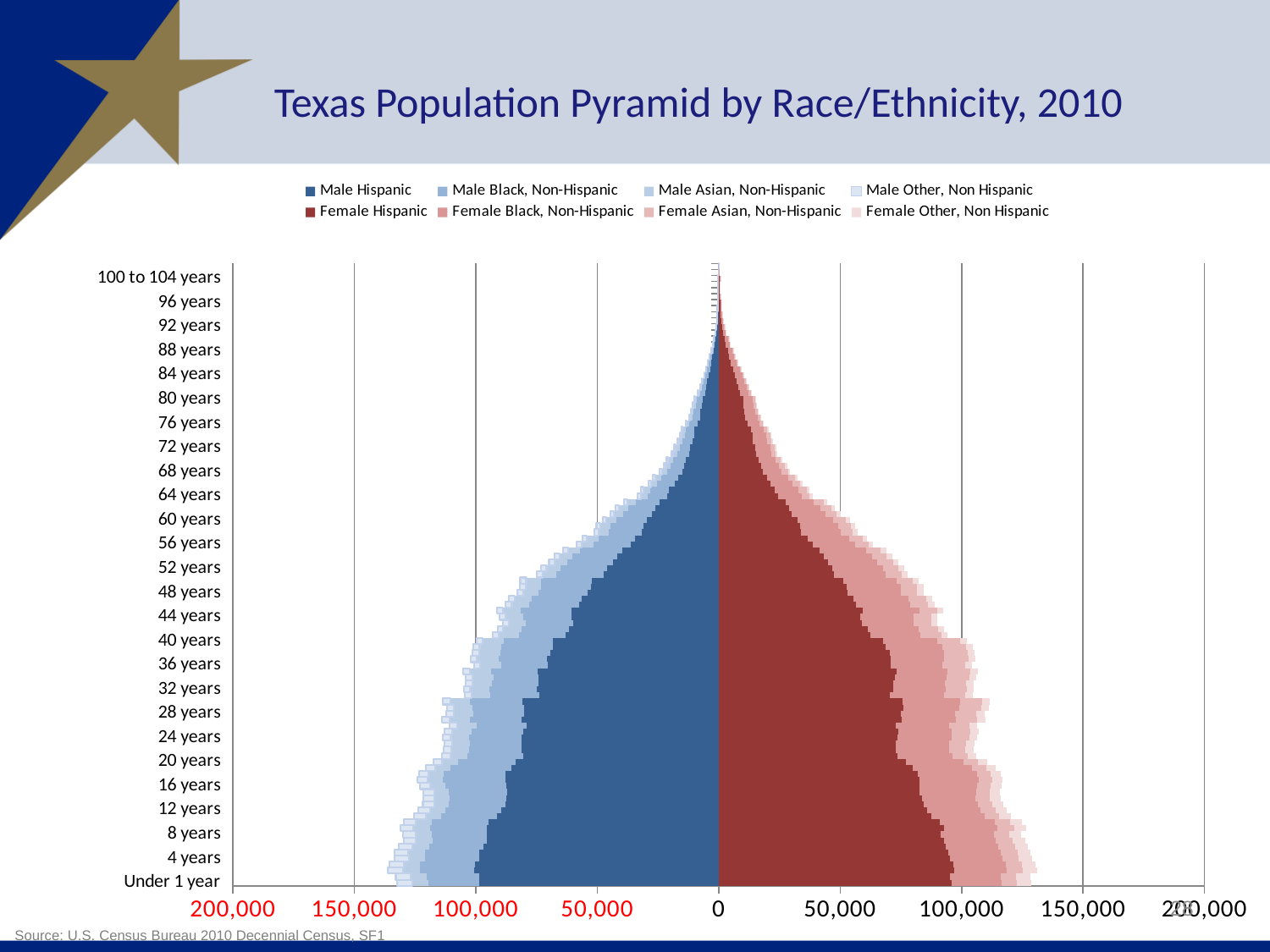
What kind of chart is shown on the slide? bar chart Is the total male population for Under 1 year greater or less than 100,000? greater Is the total male population at 80 years greater or less than 50,000? less Is the total male population at 28 years greater or less than 100,000? greater How many series does the legend list? 8 Moving from the youngest ages at the bottom to the oldest ages at the top, do the bars generally get longer or shorter? shorter What is the title of the chart? Texas Population Pyramid by Race/Ethnicity, 2010 Which side of the chart shows the male population, left or right? left